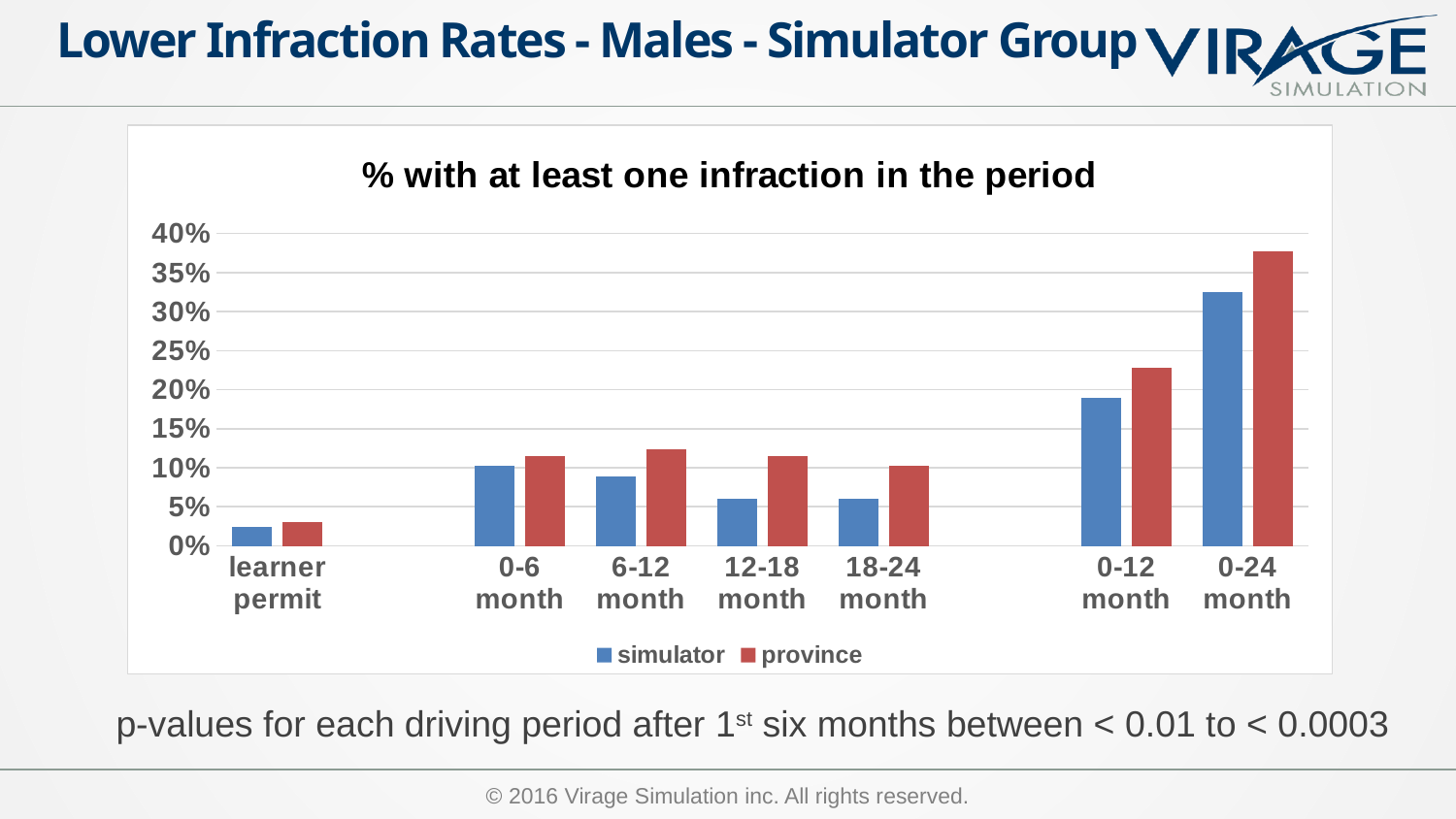
How many series does the legend list? 2 What kind of chart is shown on the slide? bar chart Is the simulator value for 12-18 month greater or less than 10%? less Which is larger: the province value for 0-12 month or the simulator value for 0-24 month? simulator value for 0-24 month Is the simulator value for 0-24 month greater or less than 30%? greater For the 12-18 month period, which series has the larger value, simulator or province? province Which category has the highest value for the simulator series? 0-24 month Which category has the lowest value for the province series? learner permit How many driving-period categories are shown on the x axis? 7 Is the province value for 0-24 month greater or less than 35%? greater What is the title of the chart? % with at least one infraction in the period